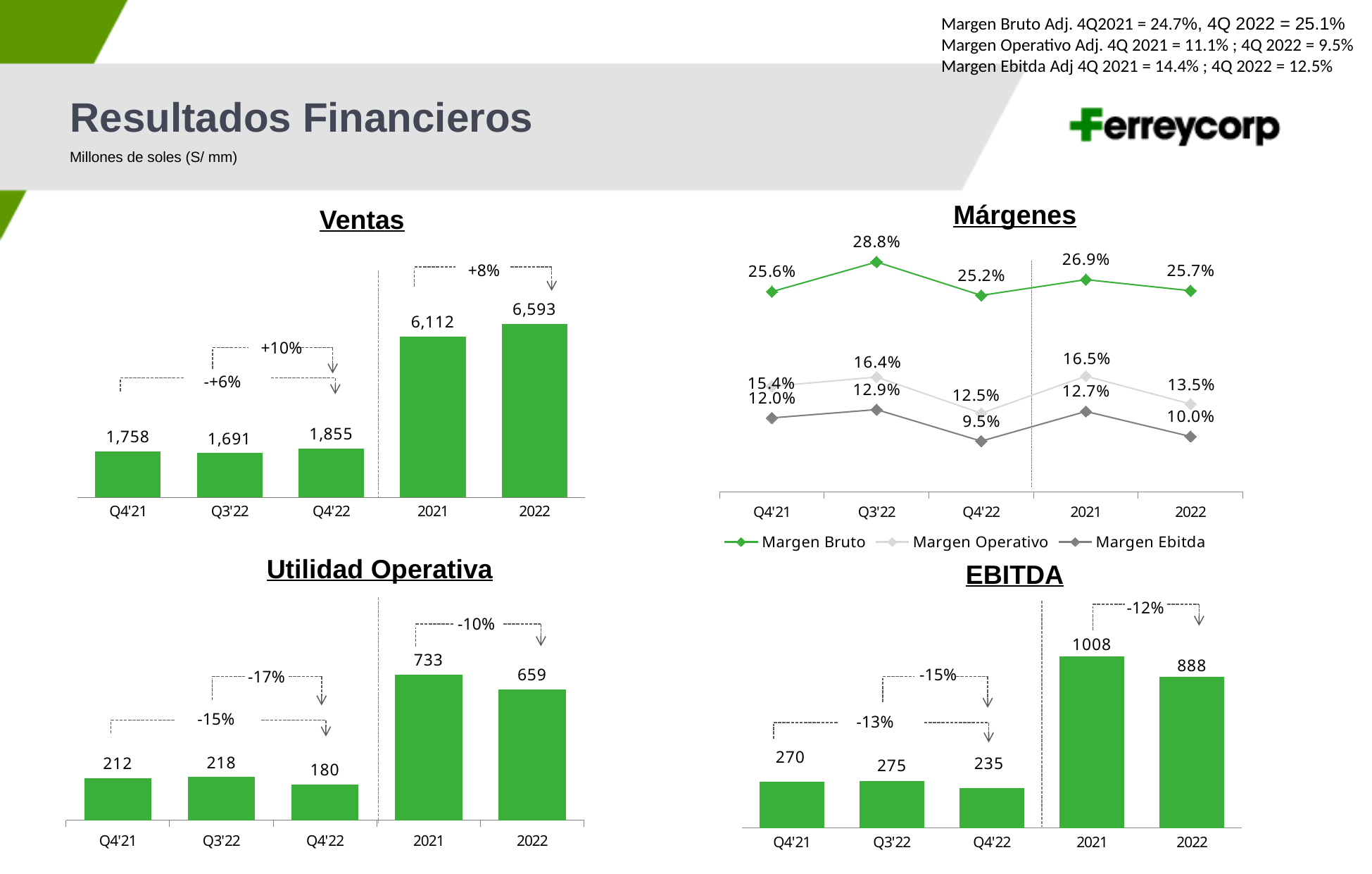
In the Utilidad Operativa chart, which is larger, the value for Q4'21 or Q3'22? Q3'22 How many categories are shown on the x axis of the EBITDA chart? 5 In the EBITDA chart, what is the value for 2021? 1008 How many series does the legend of the Márgenes chart list? 3 In the EBITDA chart, what is the difference between the 2021 and 2022 values? 120 In the Márgenes chart, what is the Margen Ebitda value for Q4'22? 9.5% What kind of chart is the Márgenes chart? line chart In the Utilidad Operativa chart, what is the value for Q4'22? 180 In the Ventas chart, what is the value for 2022? 6,593 In the Márgenes chart, what is the Margen Bruto value for Q3'22? 28.8% In the Ventas chart, what is the difference between the 2022 and 2021 values? 481 In the Ventas chart, which category has the lowest value? Q3'22